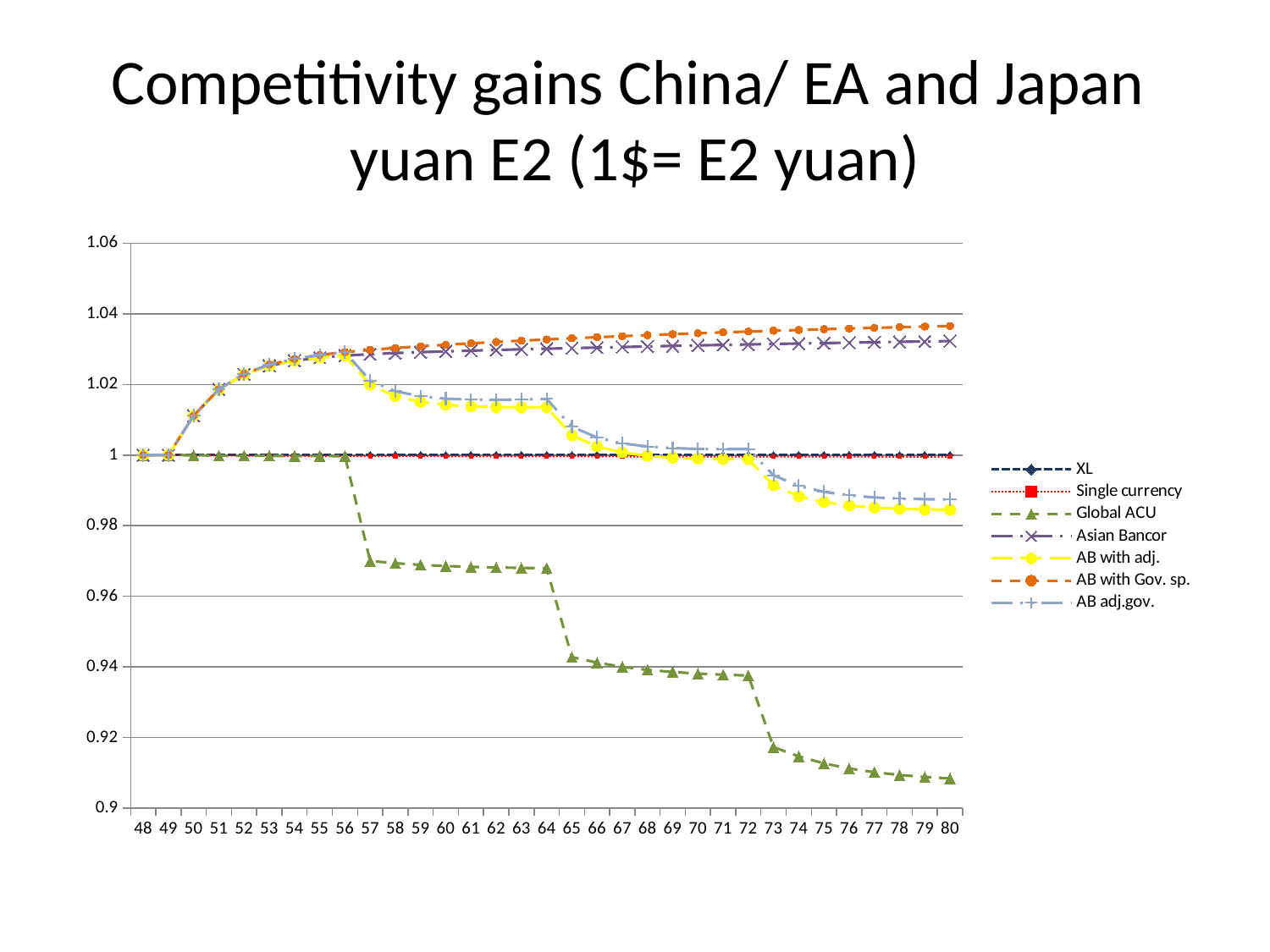
Is the value for AB with Gov. sp. at 80 greater or less than 1.02? greater Is the value for Global ACU at 80 greater or less than 0.92? less Is the value for Global ACU at 60 greater or less than 0.98? less At 80, which is larger: Global ACU or AB with adj.? AB with adj. Does the Global ACU series rise or fall along the x axis? fall What kind of chart is shown on the slide? line chart How many series does the legend list? 7 Which series has the highest value at 80? AB with Gov. sp. Which series has the lowest value at 80? Global ACU What is the title of the chart on the slide? Competitivity gains China/ EA and Japan yuan E2 (1$= E2 yuan) How many points are on the x axis (from 48 to 80)? 33